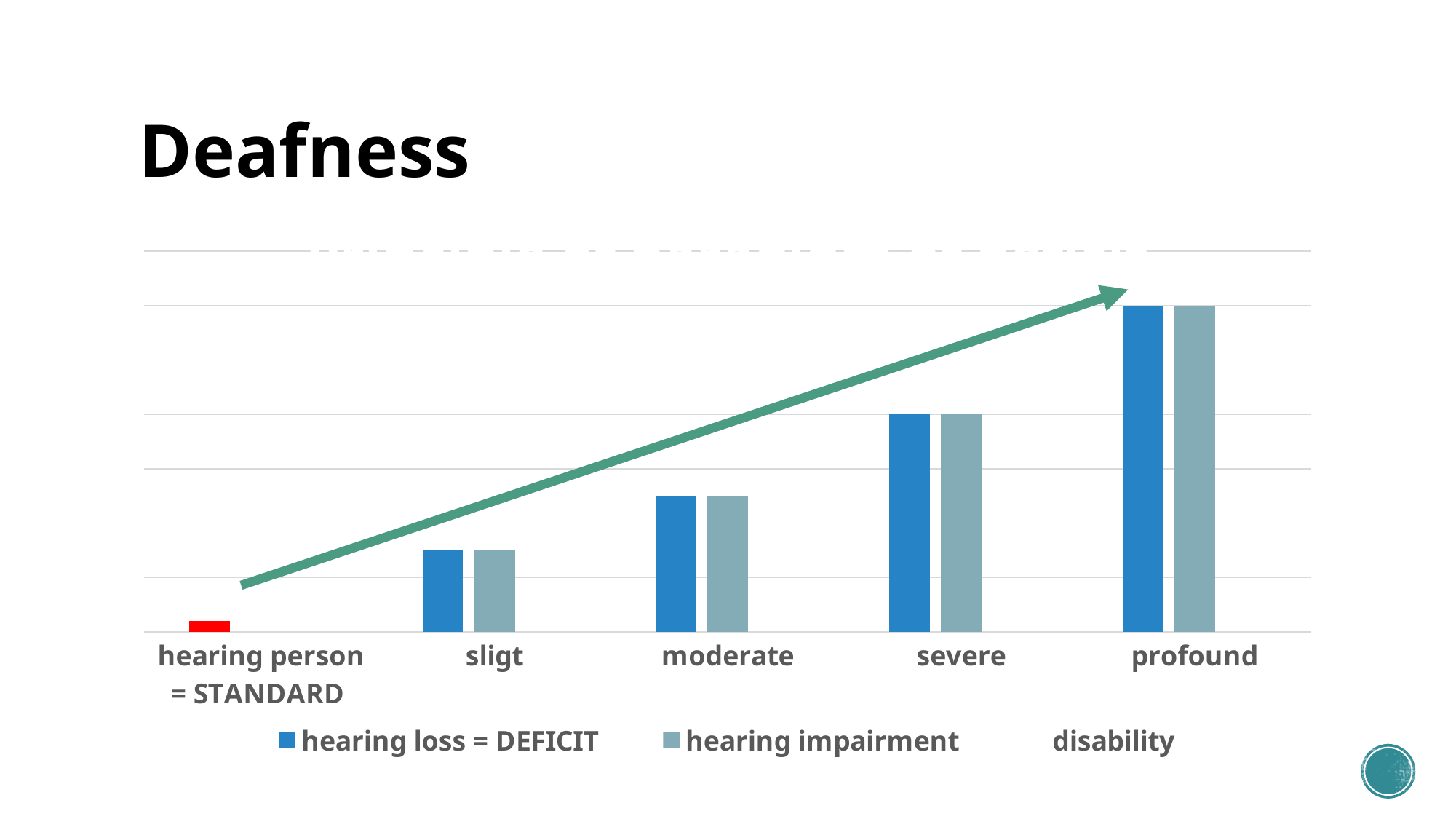
What is the title of the slide containing the chart? Deafness Which category has the tallest bars in the chart? profound What is the first entry in the chart's legend? hearing loss = DEFICIT Which is taller: the 'hearing loss = DEFICIT' bar for sligt or for moderate? moderate Do the bar heights rise or fall moving from left to right along the x axis? rise What kind of chart is shown on the slide? bar chart Which is taller: the 'hearing impairment' bar for sligt or for profound? profound How many categories are shown along the x axis of the chart? 5 Which is taller: the 'hearing loss = DEFICIT' bar for severe or for moderate? severe Which category has the shortest bar in the chart? hearing person = STANDARD How many series does the chart's legend list? 3